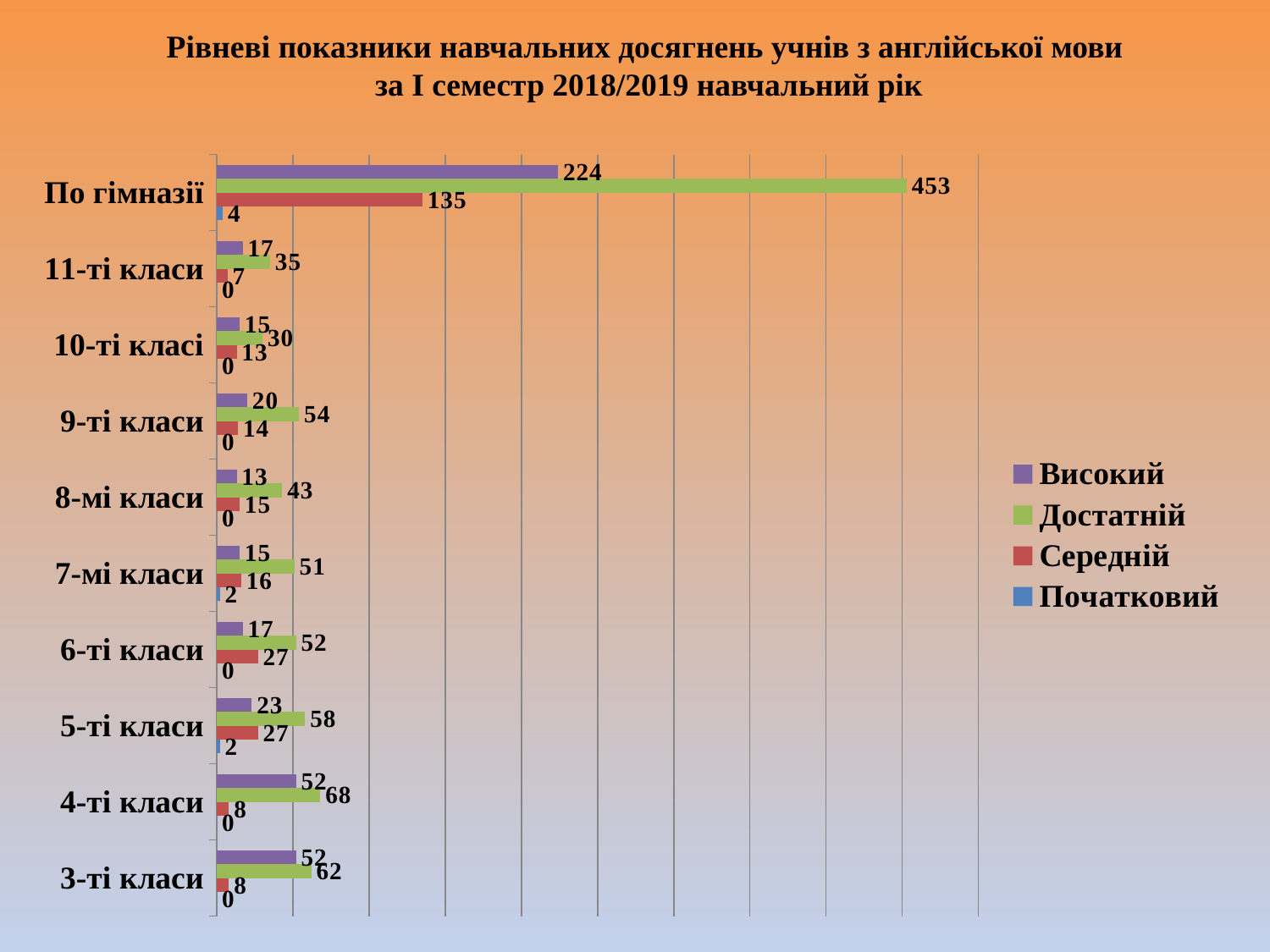
What is the difference between the Достатній and Високий values for По гімназії? 229 What is the value of Достатній for По гімназії? 453 What type of chart is shown on the slide? bar chart How many categories are shown on the vertical axis? 10 Which class category has the highest Достатній value (excluding По гімназії)? 4-ті класи What is the value of Високий for 5-ті класи? 23 Which is larger for 8-мі класи: Високий or Середній? Середній Which class category has the lowest Достатній value? 10-ті класі What is the value of Середній for 6-ті класи? 27 How many series does the legend list? 4 What is the value of Початковий for 7-мі класи? 2 Which series is shown in green in the legend? Достатній